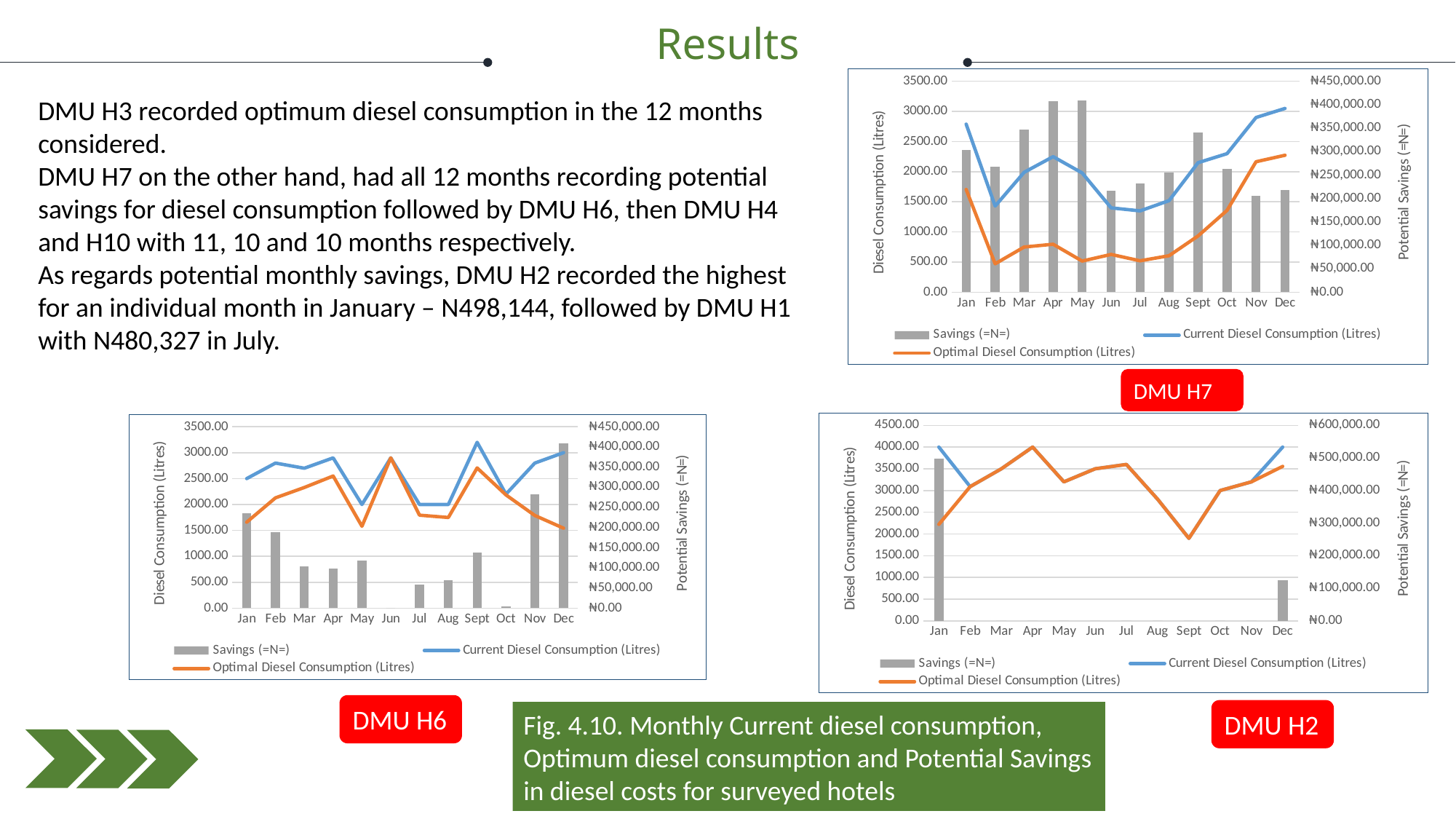
How many months are shown on the x axis of the DMU H2 chart? 12 What kind of chart is the DMU H7 chart? Combined bar and line chart How many series does the legend of the DMU H6 chart list? 3 In the DMU H7 chart, is the Current Diesel Consumption for Jan greater or less than 2500? greater In the DMU H6 chart, which month has the highest Current Diesel Consumption? Sept In the DMU H7 chart, which month has the highest Current Diesel Consumption? Dec In the DMU H6 chart, which month has the lowest Savings bar? Jun In the DMU H2 chart, is the Optimal Diesel Consumption for Apr greater or less than 3500? greater In the DMU H6 chart, which month has the highest Savings bar? Dec In the DMU H2 chart, which series is drawn in orange? Optimal Diesel Consumption (Litres) In the DMU H7 chart, does the Current Diesel Consumption rise or fall from Aug to Dec? rise In the DMU H2 chart, which month has the lowest Optimal Diesel Consumption? Sept